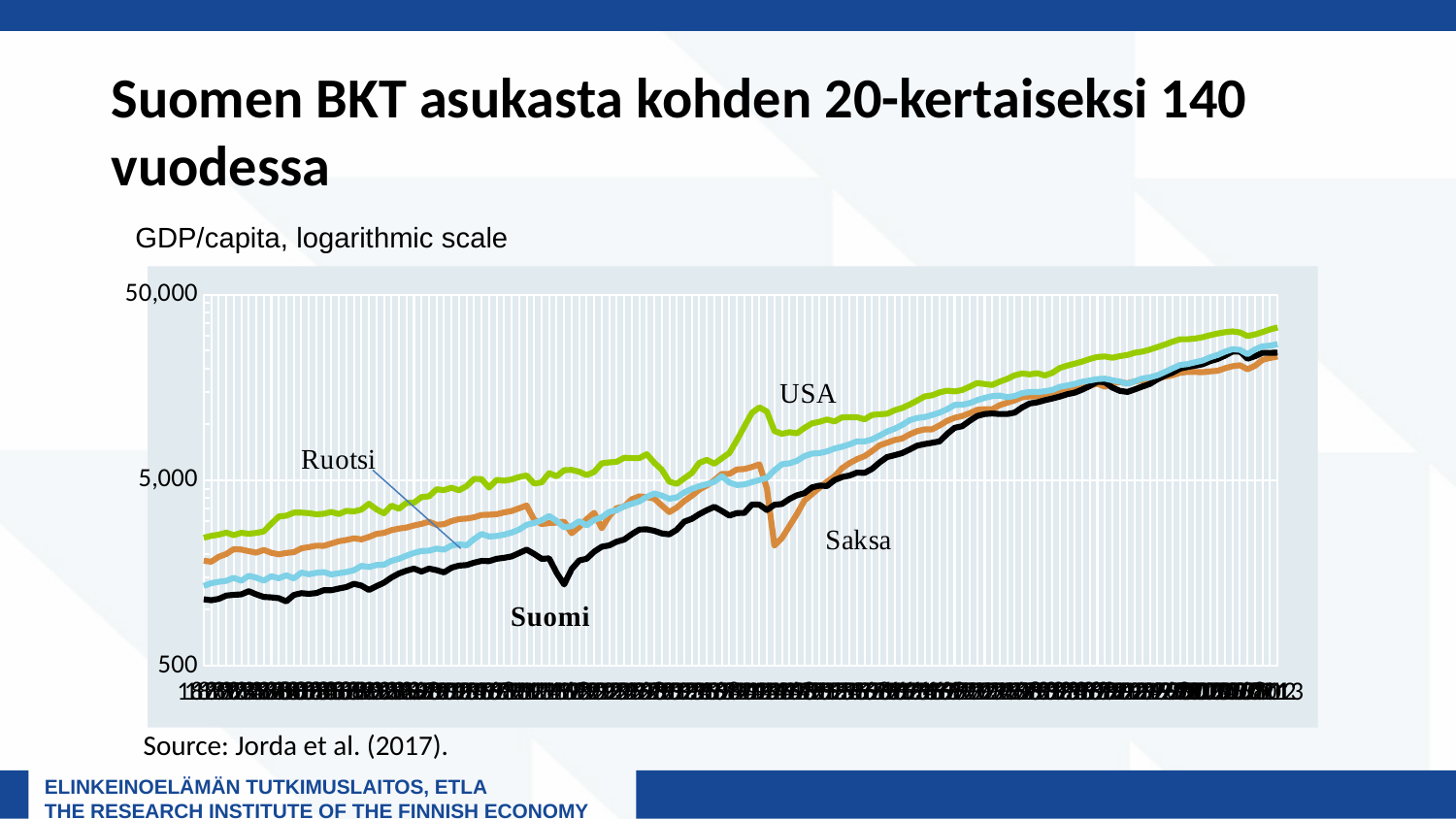
What is the subtitle describing the chart's measure and scale? GDP/capita, logarithmic scale Which country's line is the lowest at the left end of the chart? Suomi Is the value for Saksa at the right end of the chart greater or less than 50,000? less Is the value for USA at the right end of the chart greater or less than 5,000? greater How many countries' lines are plotted on the chart? 4 Which country's line is the highest at the left end of the chart? USA Do the GDP per capita lines generally rise or fall from left to right? rise Which countries are labelled on the chart? USA, Ruotsi, Saksa, Suomi At the left end of the chart, which is larger, the value for USA or the value for Suomi? USA Is the value for Suomi at the left end of the chart greater or less than 5,000? less Which country's line is the highest at the right end of the chart? USA What kind of chart is shown on the slide? line chart